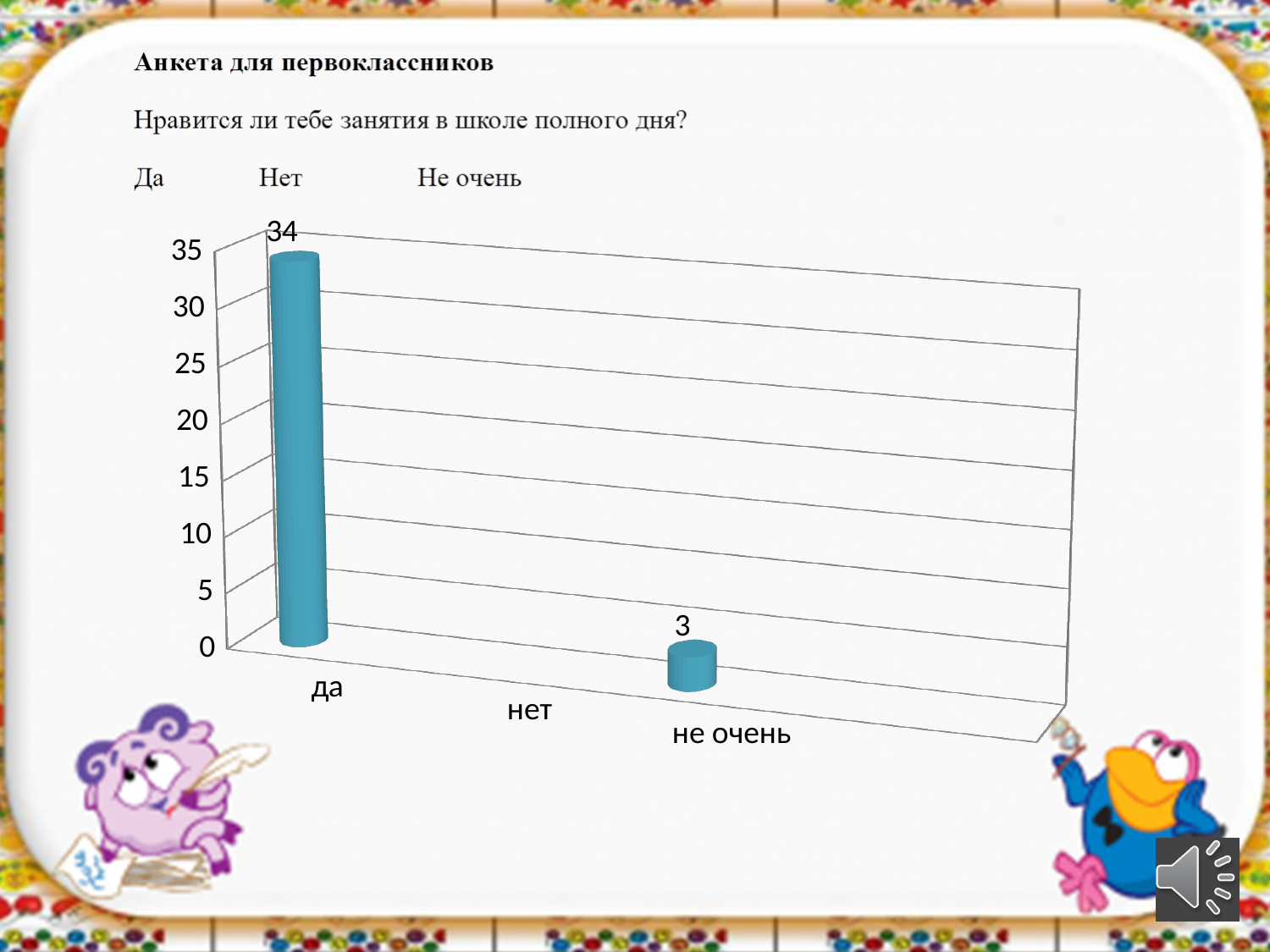
What is the highest value shown on the vertical axis? 35 Which category has the highest value? да What is the value for "да"? 34 Is the value for "не очень" greater or less than 5? less What is the value for "не очень"? 3 What kind of chart is shown on the slide? bar chart Which is larger, the value for "да" or the value for "не очень"? да What is the difference between the values for "да" and "не очень"? 31 Which category has no visible bar? нет How many categories are shown on the x axis? 3 Is the value for "да" greater or less than 30? greater